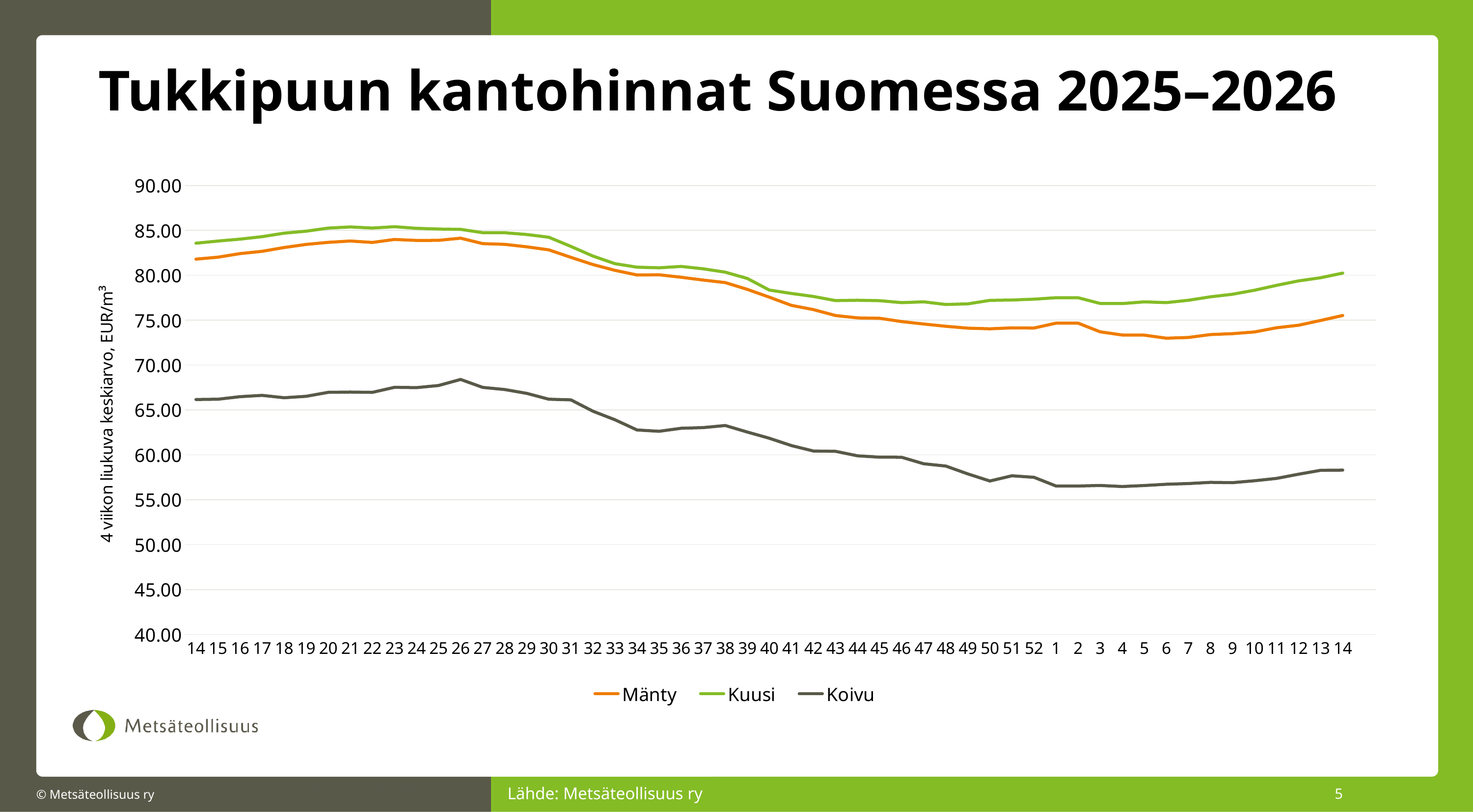
Is the value for Koivu at week 26 greater or less than 65.00? greater Is the value for Mänty at week 6 greater or less than 75.00? less What is the title of the chart? Tukkipuun kantohinnat Suomessa 2025–2026 Which series has the highest values throughout the chart? Kuusi Does the Koivu line rise or fall between week 26 and week 1? fall What kind of chart is shown on the slide? line chart At week 30, which series has the larger value, Kuusi or Mänty? Kuusi Is the value for Mänty at week 14 (the first point) greater or less than 80.00? greater How many series does the legend list? 3 Which series has the lowest values throughout the chart? Koivu Does the Mänty line rise or fall between week 6 and the final week 14? rise